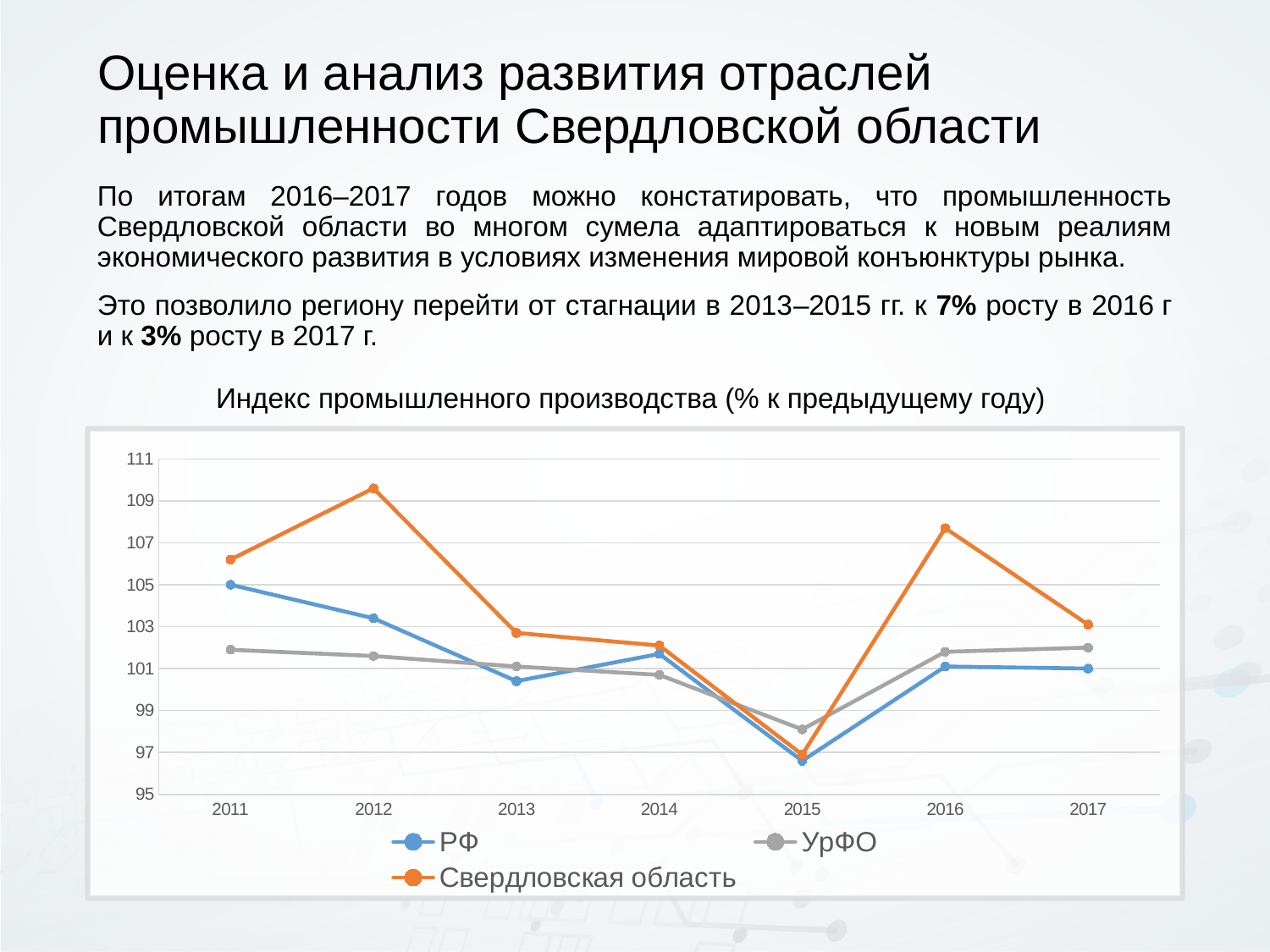
Is the value for РФ in 2015 greater or less than 99? less In which year does the Свердловская область series reach its highest value? 2012 What kind of chart is shown on the slide? line chart In which year is the УрФО series at its lowest? 2015 Is the value for Свердловская область in 2012 greater or less than 109? greater In which year is the РФ series at its lowest? 2015 Is the value for УрФО in 2015 greater or less than 99? less Does the Свердловская область series rise or fall from 2012 to 2015? fall In 2016, which series has the larger value: Свердловская область or РФ? Свердловская область How many series does the legend list? 3 In which year does the Свердловская область series reach its lowest value? 2015 How many years are plotted along the x axis? 7